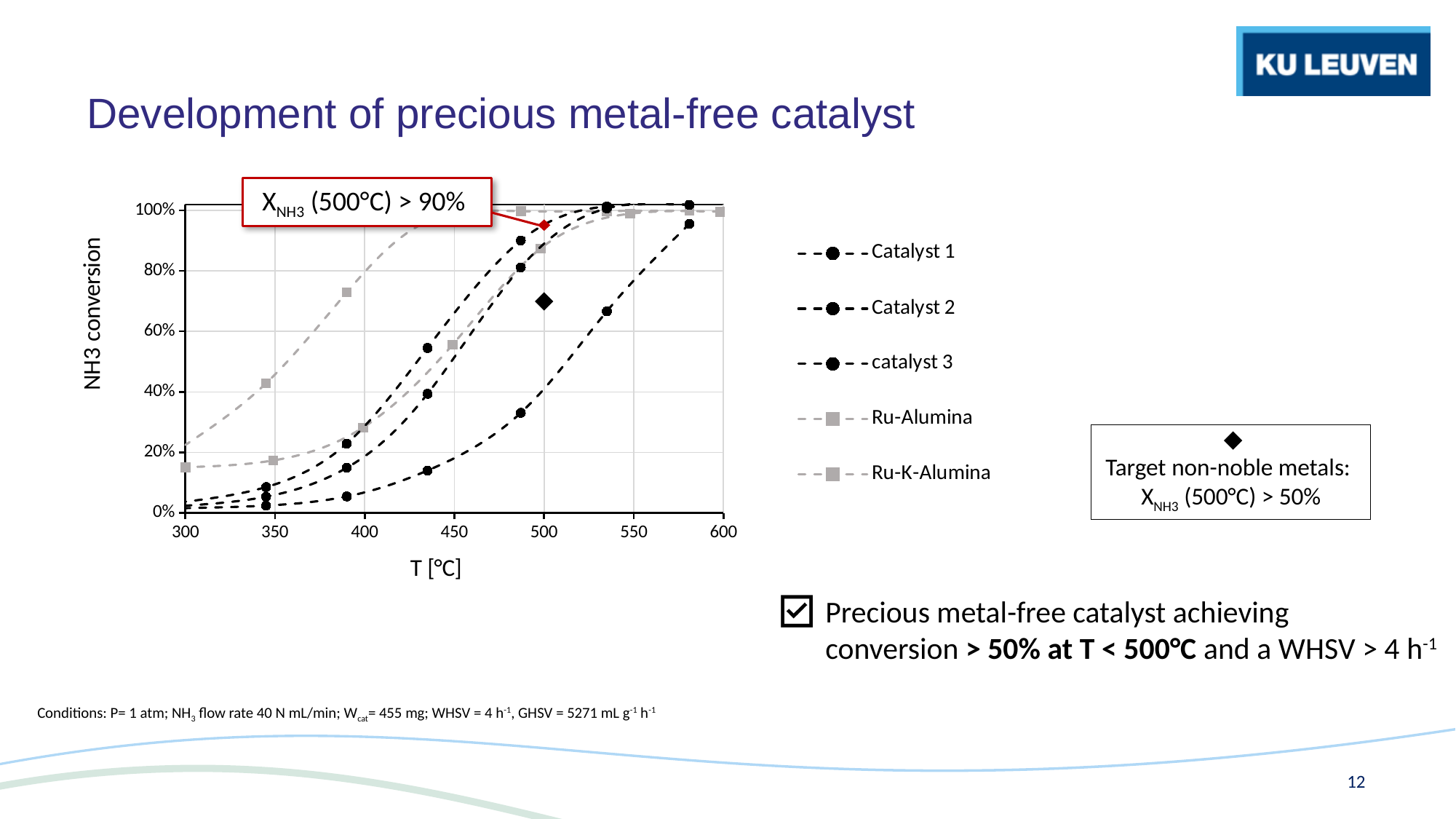
How many series does the chart legend list? 5 How many tick labels are shown on the x axis? 7 What kind of chart is shown on the slide? Line chart Is the value of the black diamond target marker greater or less than 60%? greater Is the highest conversion value plotted at 300°C greater or less than 40%? less What is the label of the chart's x axis? T [°C] What is the label of the chart's y axis? NH3 conversion Do the conversion values rise or fall as temperature increases along the x axis? Rise Which legend entries use square markers? Ru-Alumina and Ru-K-Alumina Is the highest conversion value plotted at 600°C greater or less than 80%? greater At what temperature on the x axis is the black diamond target marker placed? 500